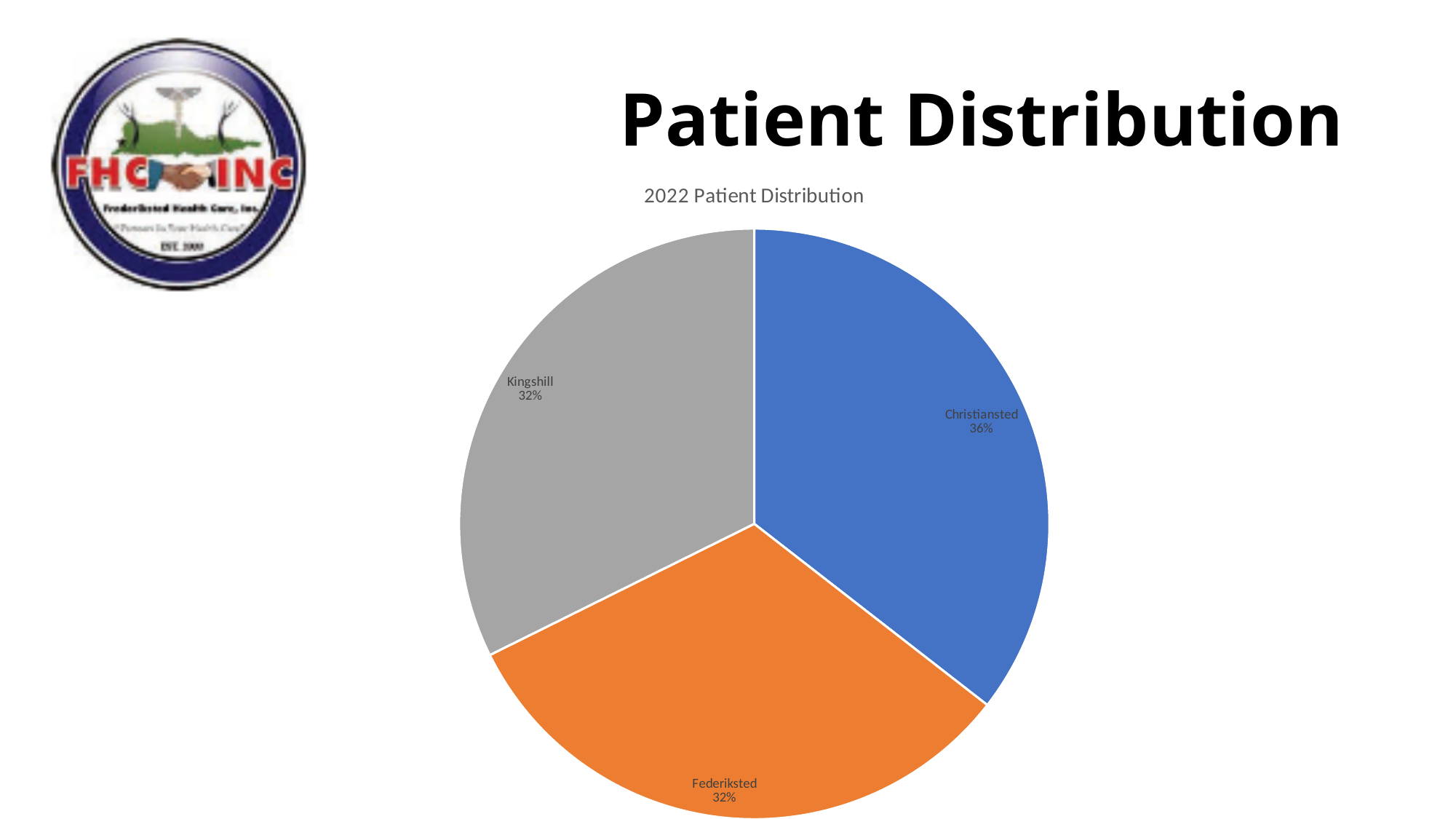
Which location has the largest share of patients? Christiansted What kind of chart is shown on the slide? Pie chart What share of patients is from Kingshill? 32% What is the combined share of Kingshill and Federiksted? 64% What is the difference in percentage points between the Christiansted and Kingshill shares? 4 What share of patients is from Federiksted? 32% What is the title of the chart? 2022 Patient Distribution What share of patients is from Christiansted? 36% What colour is the Christiansted slice? Blue Which is larger, the share for Christiansted or the share for Federiksted? Christiansted How many slices does the pie chart have? 3